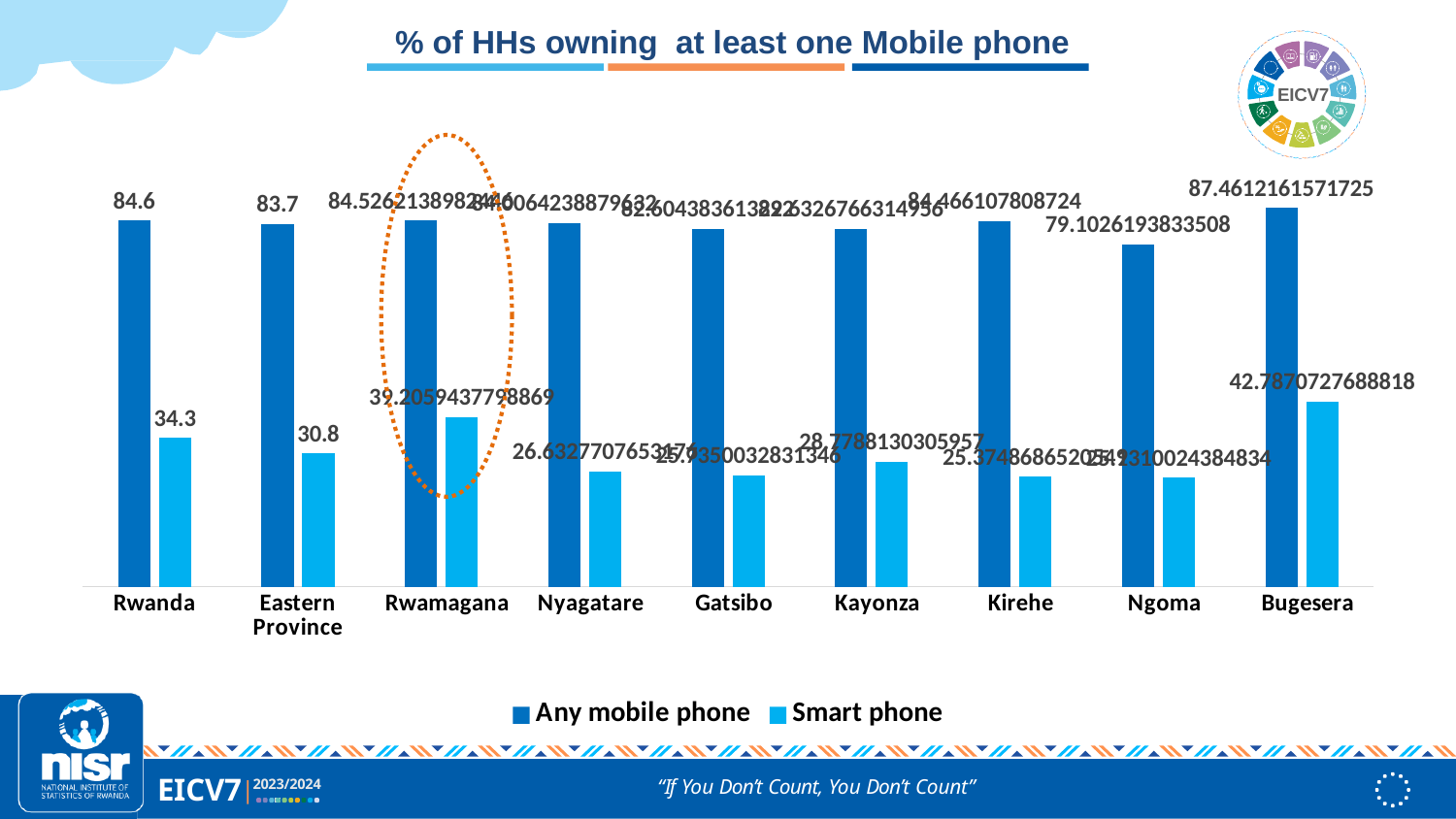
How many categories are shown on the x axis? 9 What is the value for Any mobile phone in Bugesera? 87.4612161571725 Which category has the highest Smart phone value? Bugesera Which category has the lowest Any mobile phone value? Ngoma What is the value for Any mobile phone in Eastern Province? 83.7 What is the value for Smart phone in Rwanda? 34.3 How many series does the legend list? 2 What is the difference between the Any mobile phone and Smart phone values for Rwanda? 50.3 What is the value for Any mobile phone in Ngoma? 79.1026193833508 What is the value for Any mobile phone in Rwanda? 84.6 What is the value for Smart phone in Eastern Province? 30.8 What is the value for Smart phone in Bugesera? 42.7870727688818